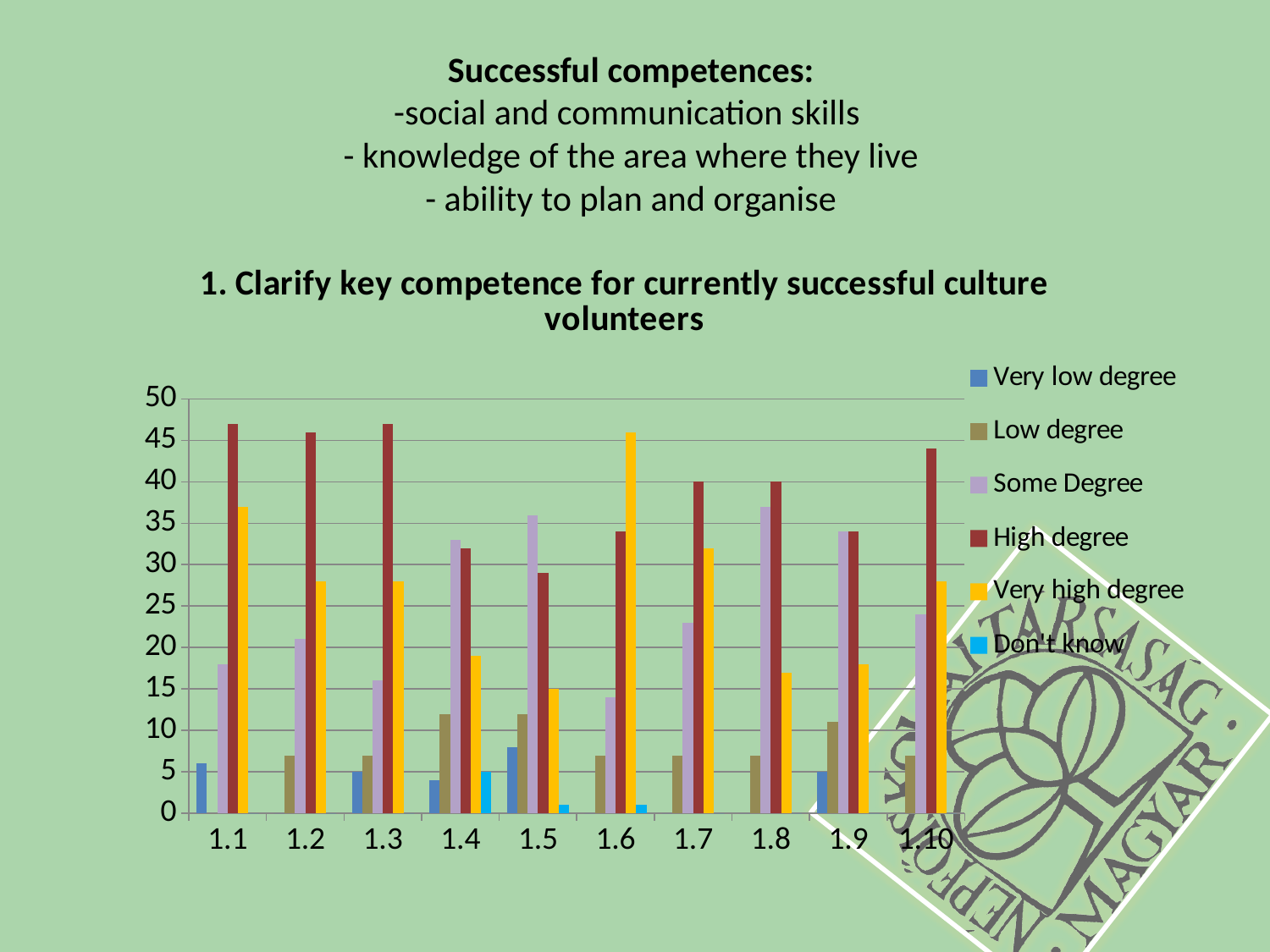
Is the High degree value for 1.1 greater or less than 45? greater How many series does the legend list? 6 For category 1.1, which is larger: High degree or Very high degree? High degree For category 1.6, which is larger: High degree or Very high degree? Very high degree What kind of chart is shown on the slide? bar chart Is the Very low degree value for 1.1 greater or less than 10? less Is the Some Degree value for 1.5 greater or less than 30? greater Which category has the highest Very high degree value? 1.6 What colour represents the Very high degree series in the legend? yellow How many categories are shown on the x axis? 10